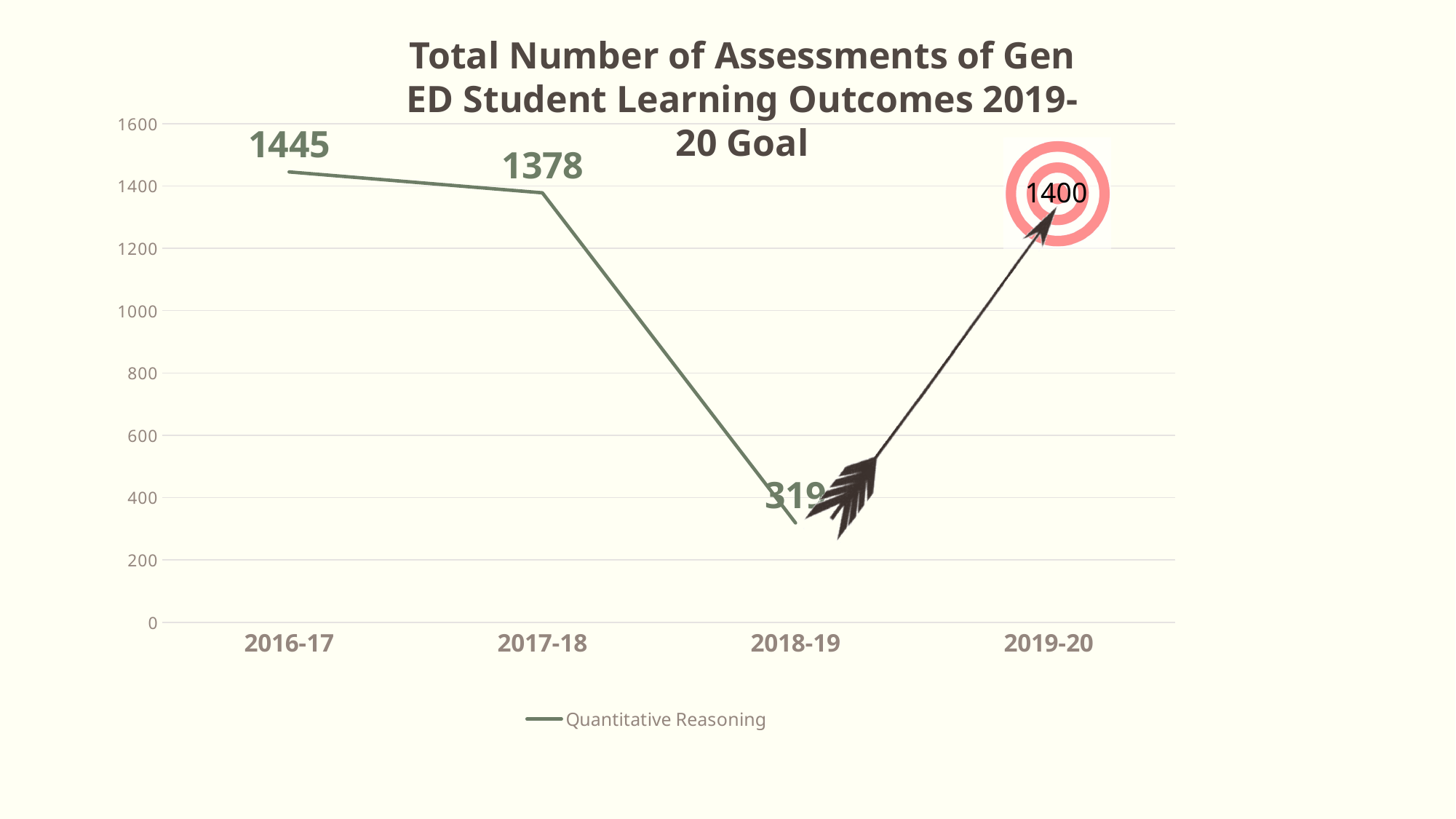
Which year has the highest plotted value? 2016-17 How many year categories are shown on the x axis? 4 What is the value for 2016-17? 1445 Which year has the lowest plotted value? 2018-19 What is the value for 2018-19? 319 What is the difference between the values for 2016-17 and 2017-18? 67 What is the value for 2017-18? 1378 Which is larger, the value for 2016-17 or the value for 2018-19? 2016-17 Is the value for 2018-19 greater or less than 400? less What series does the legend list? Quantitative Reasoning What is the difference between the values for 2017-18 and 2018-19? 1059 What kind of chart is this? line chart